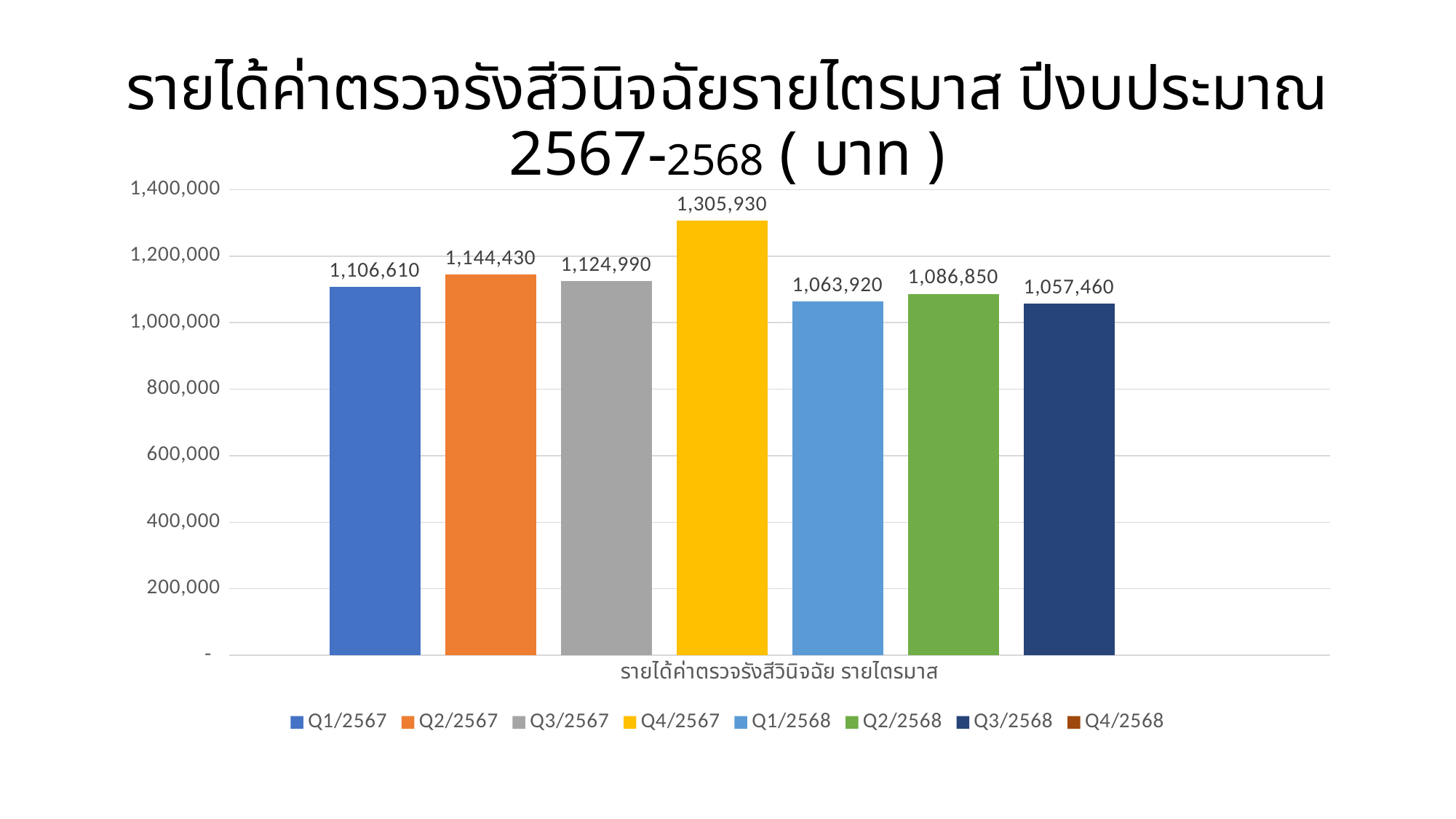
Which quarter has the lowest value? Q3/2568 Which quarter has the highest value? Q4/2567 What kind of chart is shown on the slide? bar chart Is the value for Q4/2567 greater or less than 1,200,000? greater What is the difference between the values for Q2/2567 and Q3/2567? 19,440 What is the value for Q1/2568? 1,063,920 Which is larger, the value for Q1/2567 or the value for Q2/2568? Q1/2567 What is the value for Q4/2567? 1,305,930 What is the difference between the values for Q4/2567 and Q3/2568? 248,470 How many series does the legend list? 8 What is the value for Q2/2567? 1,144,430 How many bars are plotted on the chart? 7